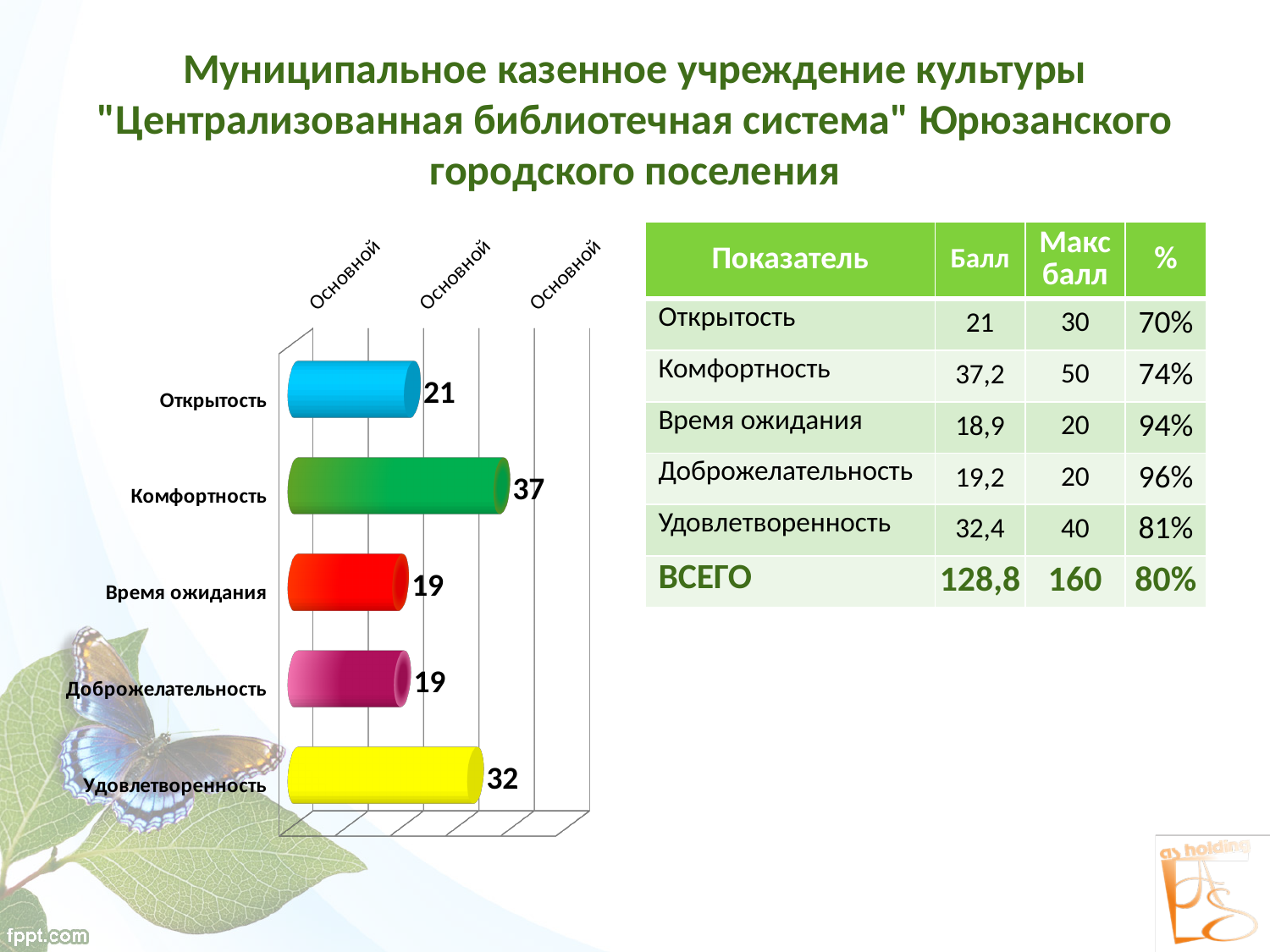
What is the value for Удовлетворенность in the bar chart? 32 Which category has the highest value in the bar chart? Комфортность What is the lowest value shown in the bar chart? 19 What is the difference between the values for Комфортность and Удовлетворенность in the bar chart? 5 What is the value for Открытость in the bar chart? 21 What type of chart is shown on the slide? bar chart How many categories are shown in the bar chart? 5 What is the value for Время ожидания in the bar chart? 19 What colour is the bar for Удовлетворенность in the chart? yellow Which is larger in the bar chart, Удовлетворенность or Открытость? Удовлетворенность What is the value for Комфортность in the bar chart? 37 What is the difference between the values for Открытость and Доброжелательность in the bar chart? 2